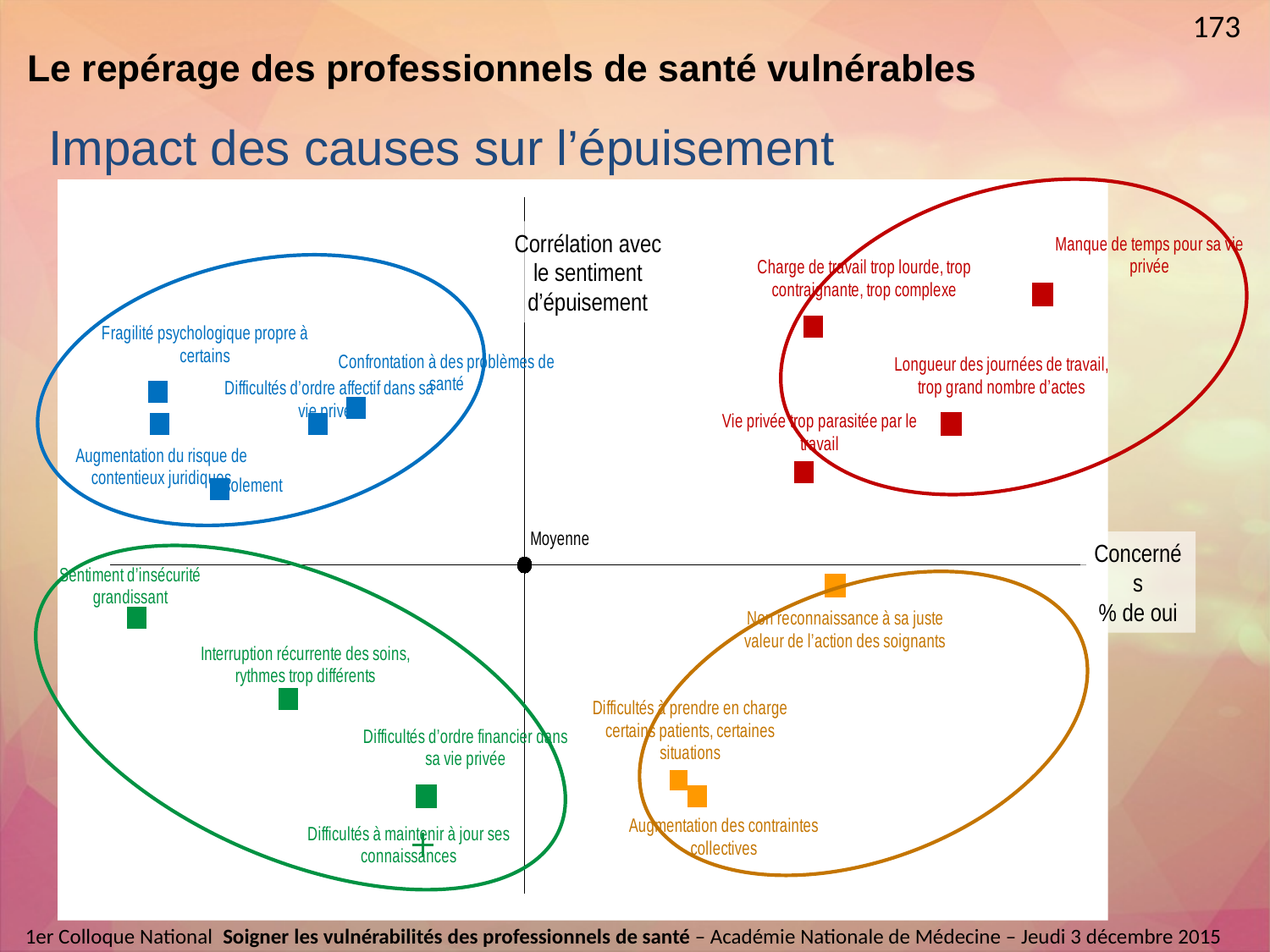
How many coloured ellipses group the points on the chart? 4 Which cause is plotted furthest to the left (lowest % of 'oui')? Sentiment d'insécurité grandissant Which cause is plotted furthest to the right (highest % of 'oui')? Manque de temps pour sa vie privée What kind of chart is shown on the slide? Scatter chart How many points are enclosed in the red ellipse? 4 Which cause is plotted highest on the chart (strongest correlation with exhaustion)? Manque de temps pour sa vie privée How many points are enclosed in the orange ellipse? 3 What is the title of the chart? Impact des causes sur l'épuisement Which cause is plotted lowest on the chart (weakest correlation with exhaustion)? Difficultés à maintenir à jour ses connaissances What does the vertical axis of the chart represent? Corrélation avec le sentiment d'épuisement What label is given to the black point at the intersection of the two axes? Moyenne Which is plotted higher on the correlation axis: 'Charge de travail trop lourde, trop contraignante, trop complexe' or 'Vie privée trop parasitée par le travail'? Charge de travail trop lourde, trop contraignante, trop complexe